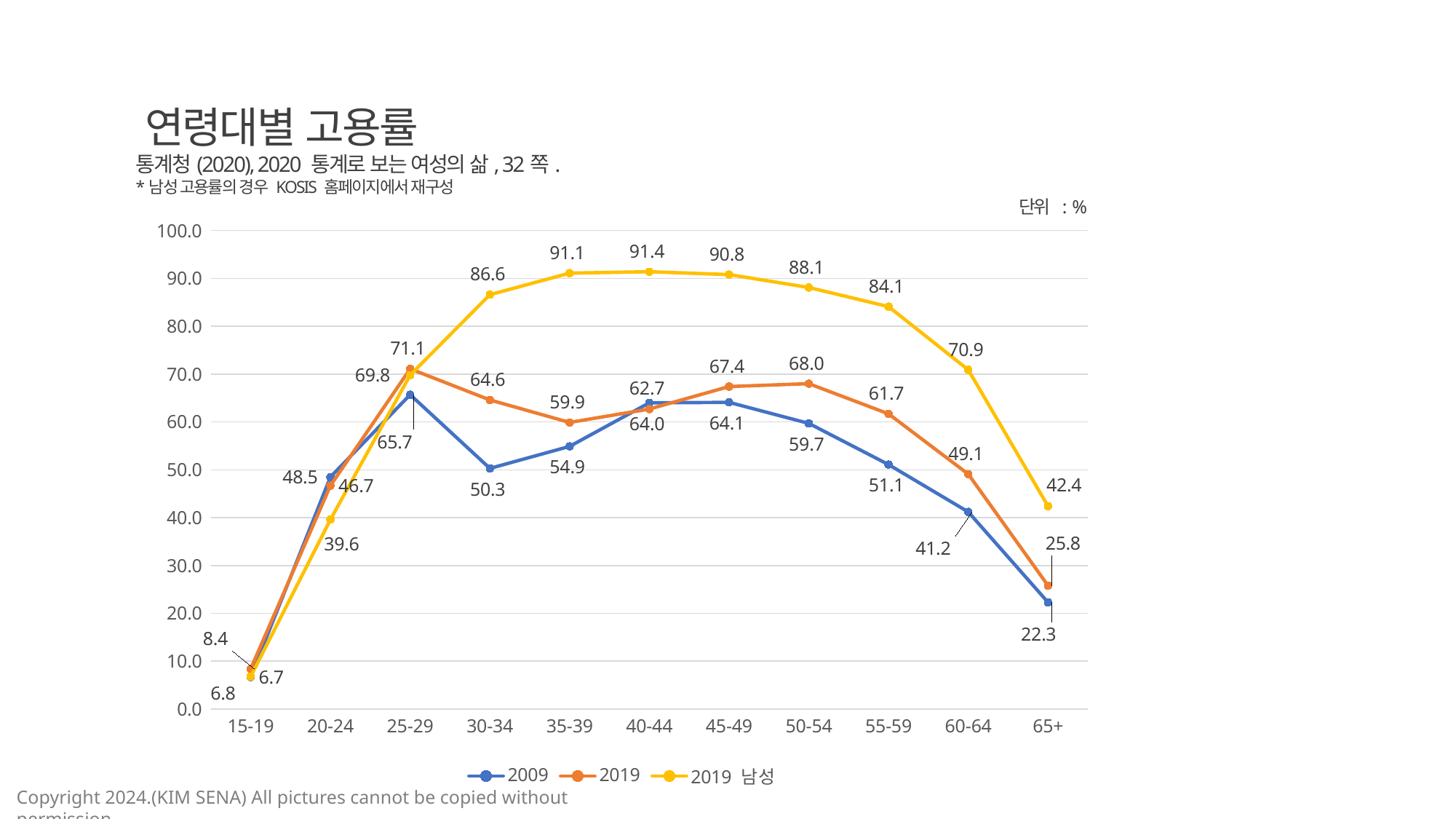
How many age groups are shown on the x axis? 11 Which is larger at 60-64: the 2019 value or the 2009 value? 2019 What is the value for the 2009 series at 25-29? 65.7 What type of chart is shown on the slide? line chart How many series does the legend list? 3 What is the value for the 2019 series at 50-54? 68.0 Is the value for the 2019 남성 series at 65+ greater or less than 40.0? greater What is the unit shown for the chart values? % What is the difference between the 2019 and 2009 values at 30-34? 14.3 Which age group has the highest value for the 2019 series? 25-29 What is the value for the 2019 남성 series at 40-44? 91.4 Which age group has the highest value for the 2019 남성 series? 40-44